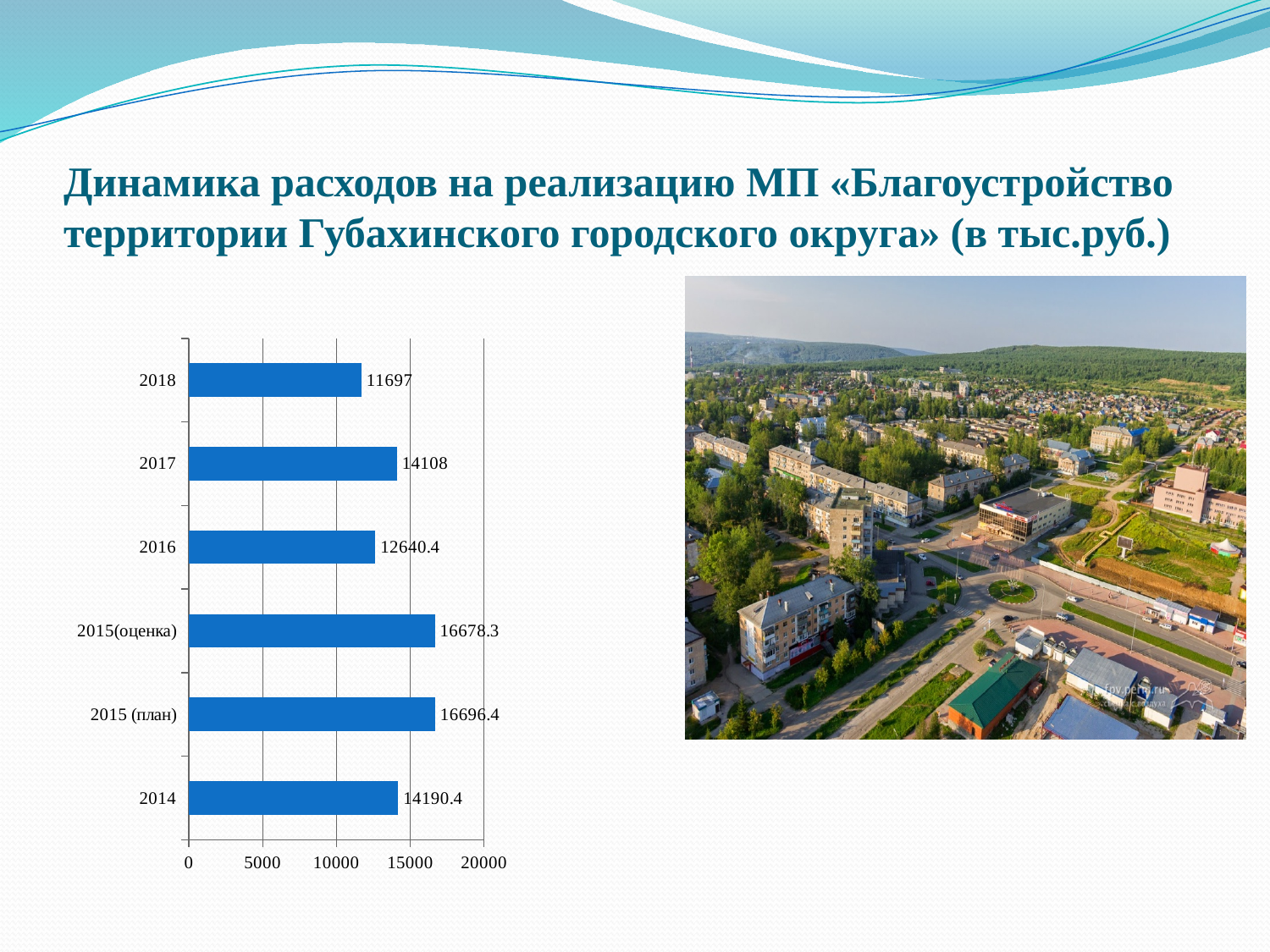
Is the value for 2015(оценка) greater or less than 15000? greater What is the difference between the values for 2017 and 2018? 2411 What is the value for 2016? 12640.4 What is the value for 2015 (план)? 16696.4 What is the maximum value shown on the horizontal axis? 20000 What kind of chart is shown on the slide? bar chart How many categories are shown in the chart? 6 What is the value for 2018? 11697 Which is larger, the value for 2017 or the value for 2016? 2017 What is the value for 2014? 14190.4 What is the difference between the values for 2014 and 2016? 1550 Which category has the lowest value? 2018